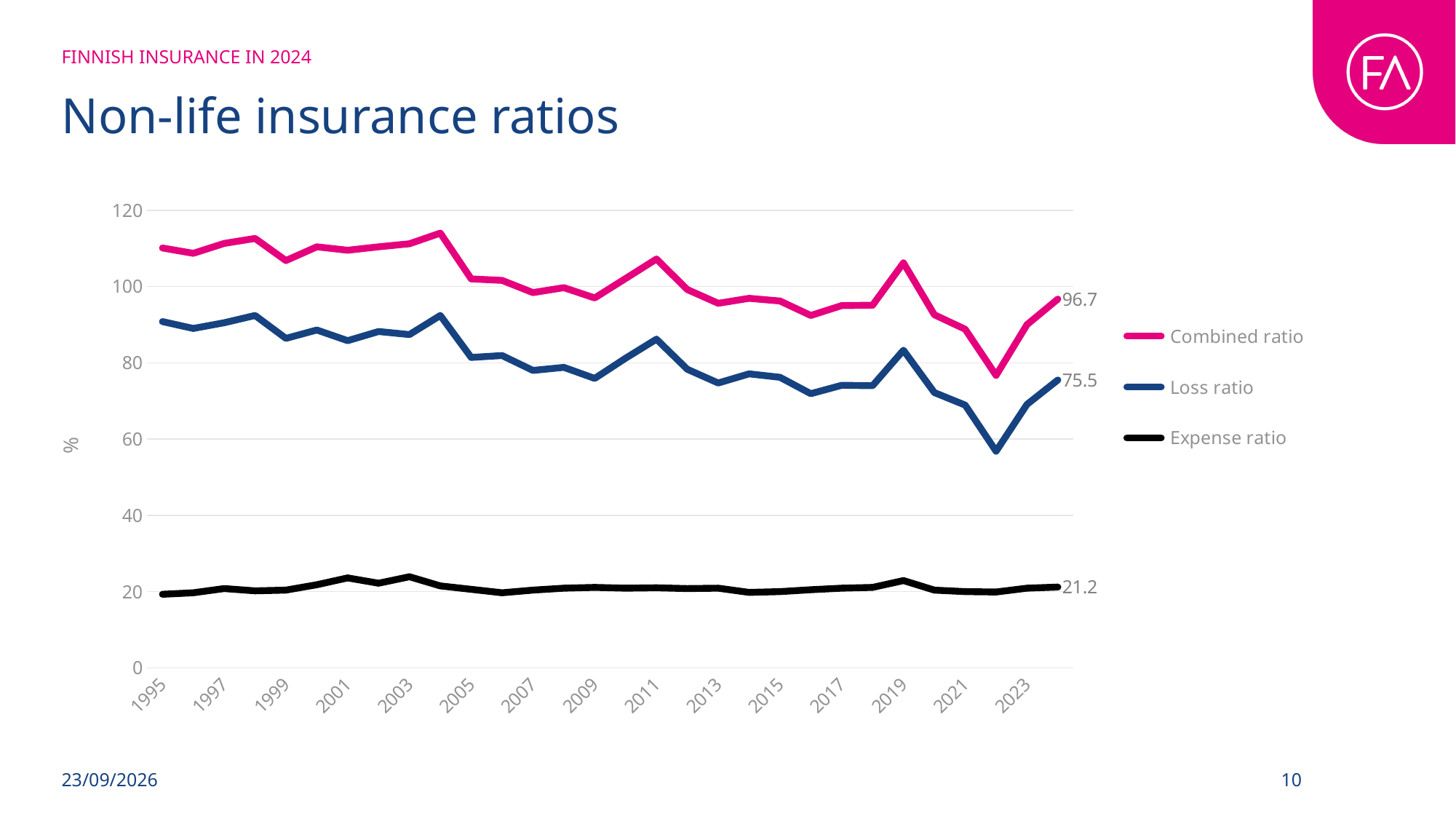
What unit is shown on the y axis? % What is the labelled final value of the Loss ratio line? 75.5 What is the labelled final value of the Expense ratio line? 21.2 What is the labelled final value of the Combined ratio line? 96.7 Which series has the highest values throughout the chart? Combined ratio Is the value of the Combined ratio in 1995 greater or less than 100? greater What is the difference between the final labelled values of the Combined ratio and the Loss ratio? 21.2 Which series has the lowest values throughout the chart? Expense ratio How many series does the legend list? 3 Which is larger: the Combined ratio in 2004 or the Combined ratio in 2022? 2004 What kind of chart is shown on the slide? Line chart Is the value of the Loss ratio in 2022 greater or less than 60? less